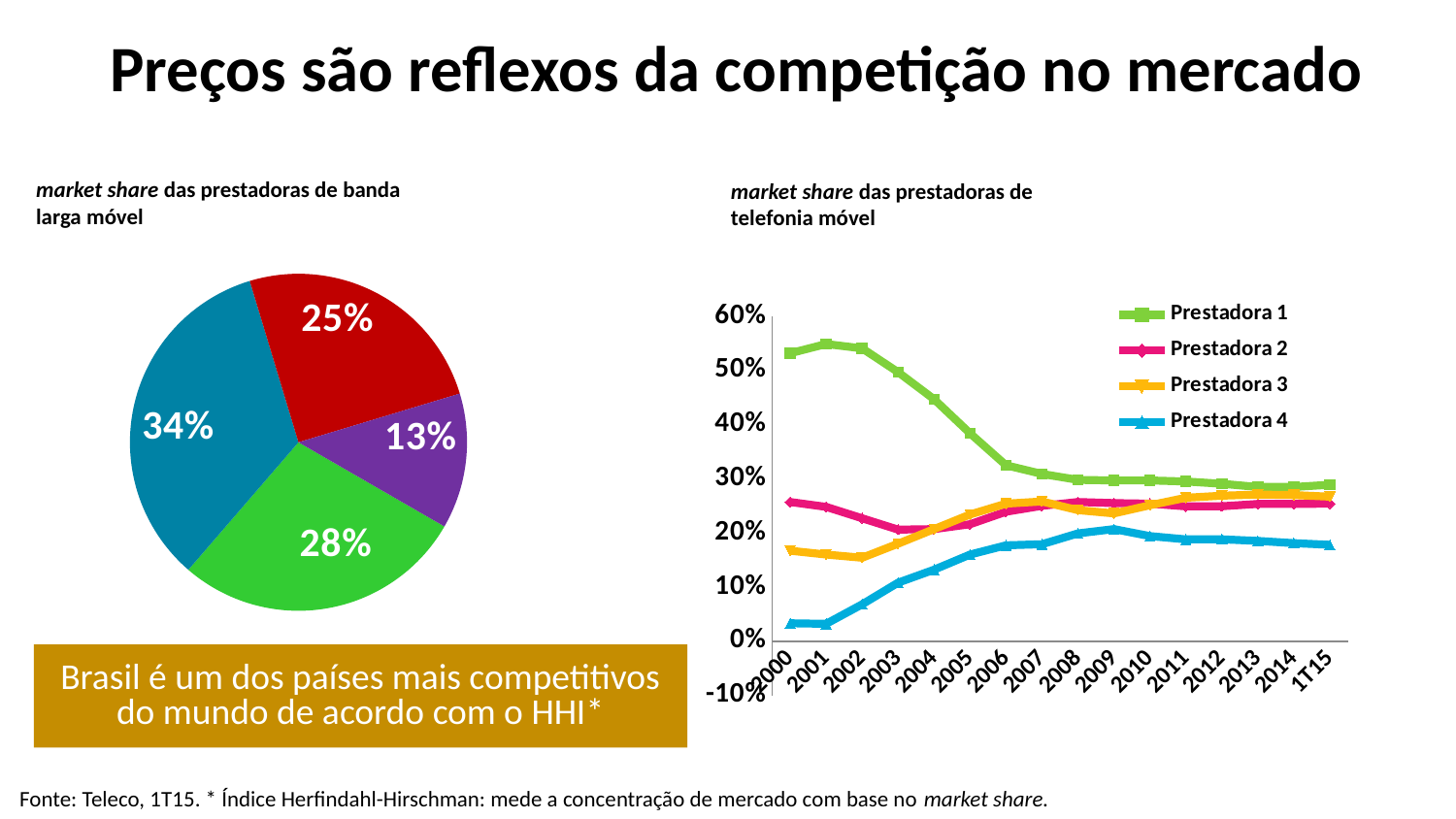
In the left pie chart, what share does the red slice represent? 25% What type of chart is the right chart, 'market share das prestadoras de telefonia móvel'? line chart In the right chart, which series has the highest market share in 2000? Prestadora 1 In the left pie chart, what is the largest slice's share? 34% In the right chart, does the market share of Prestadora 1 rise or fall from 2000 to 1T15? fall In the right chart, which is larger in 2000: Prestadora 2 or Prestadora 3? Prestadora 2 In the left pie chart, what is the difference between the largest slice (34%) and the smallest slice (13%)? 21 percentage points How many slices does the left pie chart have? 4 How many series does the legend of the right chart list? 4 In the left pie chart, what is the smallest slice's share? 13% In the right chart, is the value for Prestadora 1 in 2000 greater or less than 50%? greater What type of chart is the left chart, 'market share das prestadoras de banda larga móvel'? pie chart